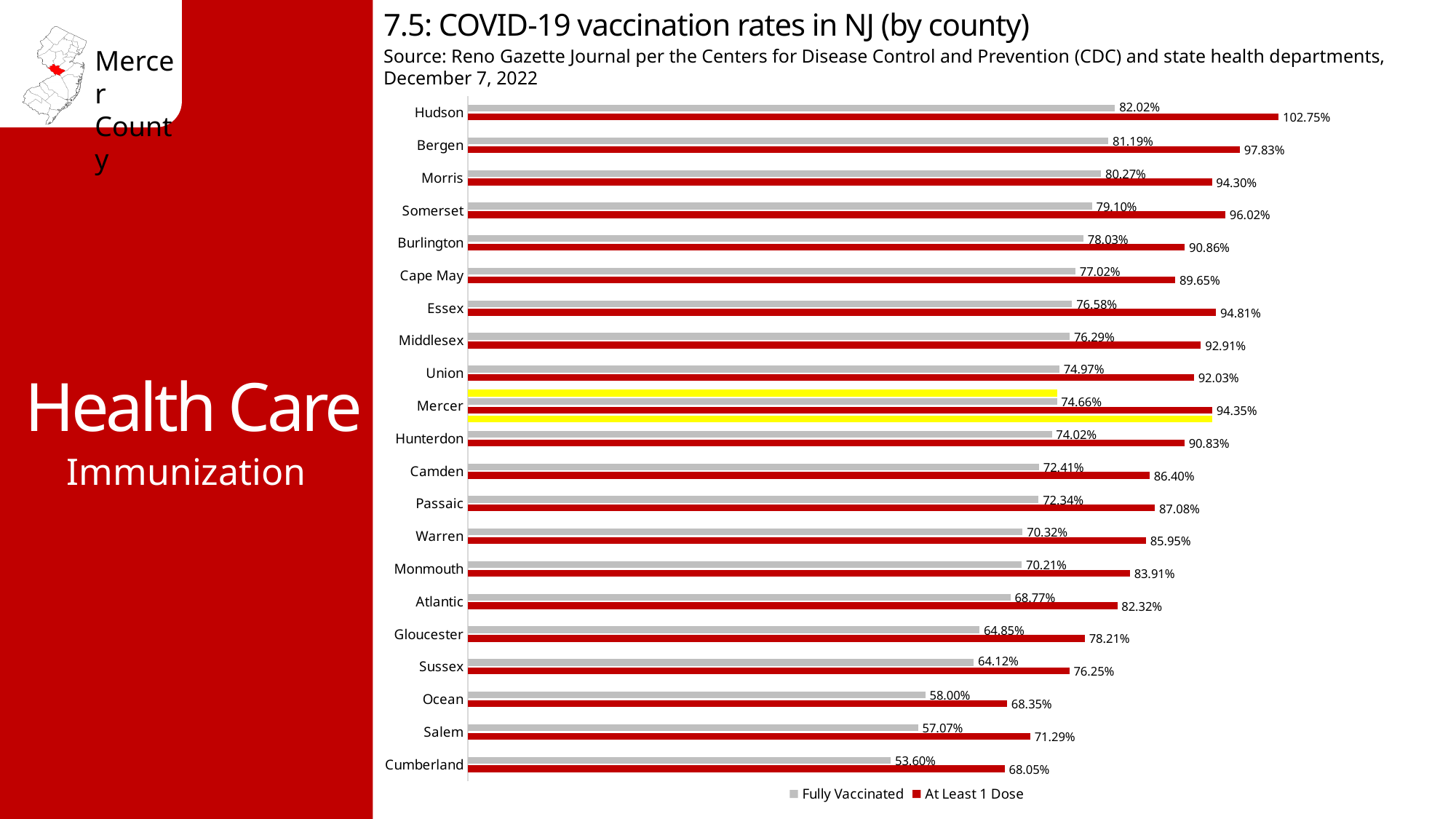
What is the At Least 1 Dose rate for Hudson County? 102.75% Which county has the lowest At Least 1 Dose rate? Cumberland Which county has the lowest Fully Vaccinated rate? Cumberland How many series does the legend list? 2 What is the At Least 1 Dose rate for Cumberland County? 68.05% Which county has the highest Fully Vaccinated rate? Hudson What is the difference between the Fully Vaccinated rates of Hudson and Bergen counties? 0.83% What type of chart is shown on the slide? Bar chart How many counties are shown in the chart? 21 Which county has a higher At Least 1 Dose rate, Essex or Morris? Essex What is the Fully Vaccinated rate for Mercer County? 74.66% What is the difference between the At Least 1 Dose rate and the Fully Vaccinated rate for Mercer County? 19.69%